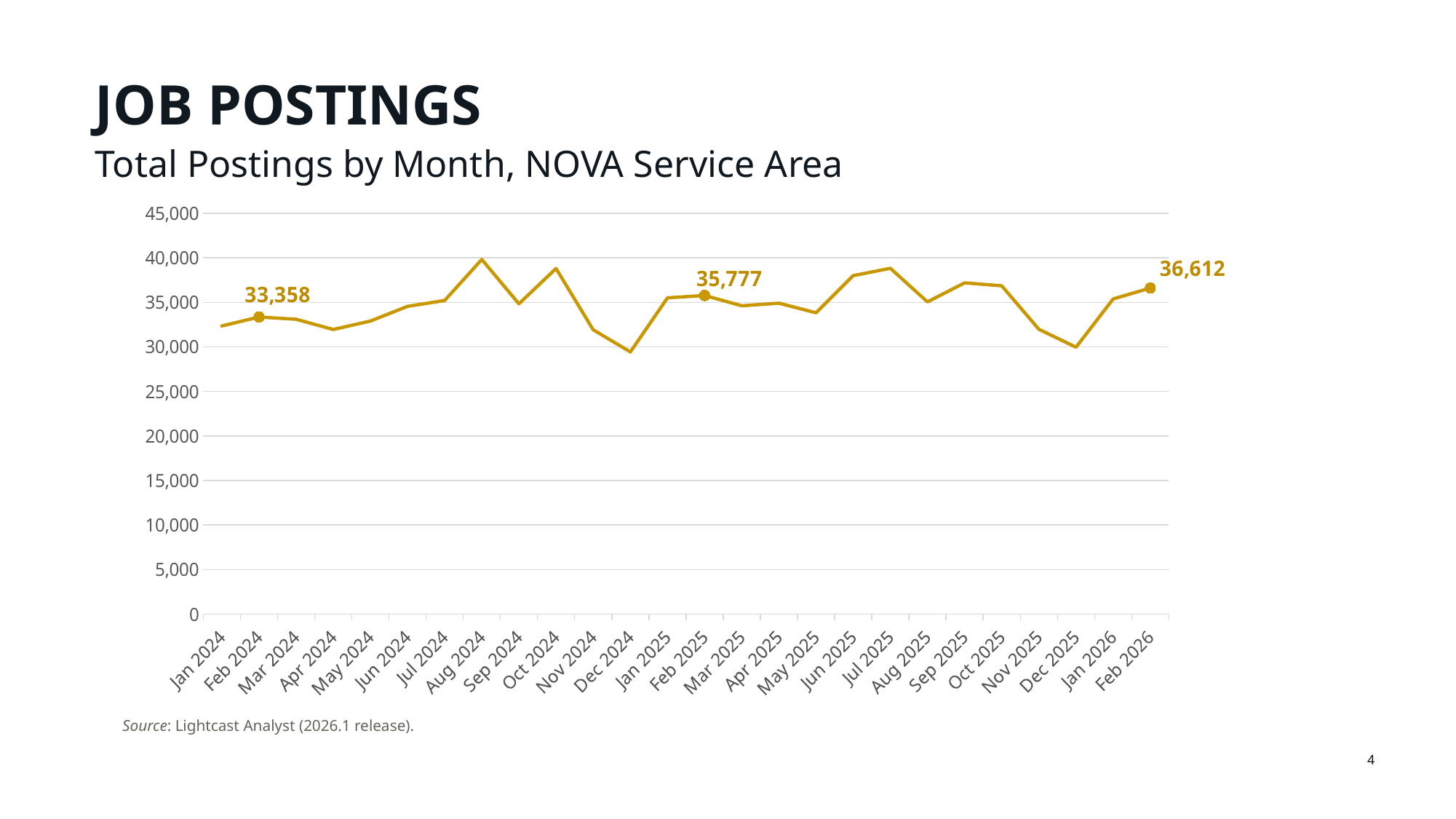
Is the value for Jan 2024 greater or less than 35,000? less What is the value for Feb 2025? 35,777 Which is larger, the value for Feb 2024 or the value for Feb 2026? Feb 2026 Is the value for Nov 2025 greater or less than 35,000? less What is the difference between the Feb 2026 and Feb 2025 values? 835 What kind of chart is shown on the slide? line chart Is the value for Aug 2024 greater or less than 35,000? greater What is the value for Feb 2024? 33,358 What is the value for Feb 2026? 36,612 How many months are plotted on the x axis? 26 What is the difference between the Feb 2025 and Feb 2024 values? 2,419 Do the values rise or fall from Dec 2025 to Feb 2026? rise